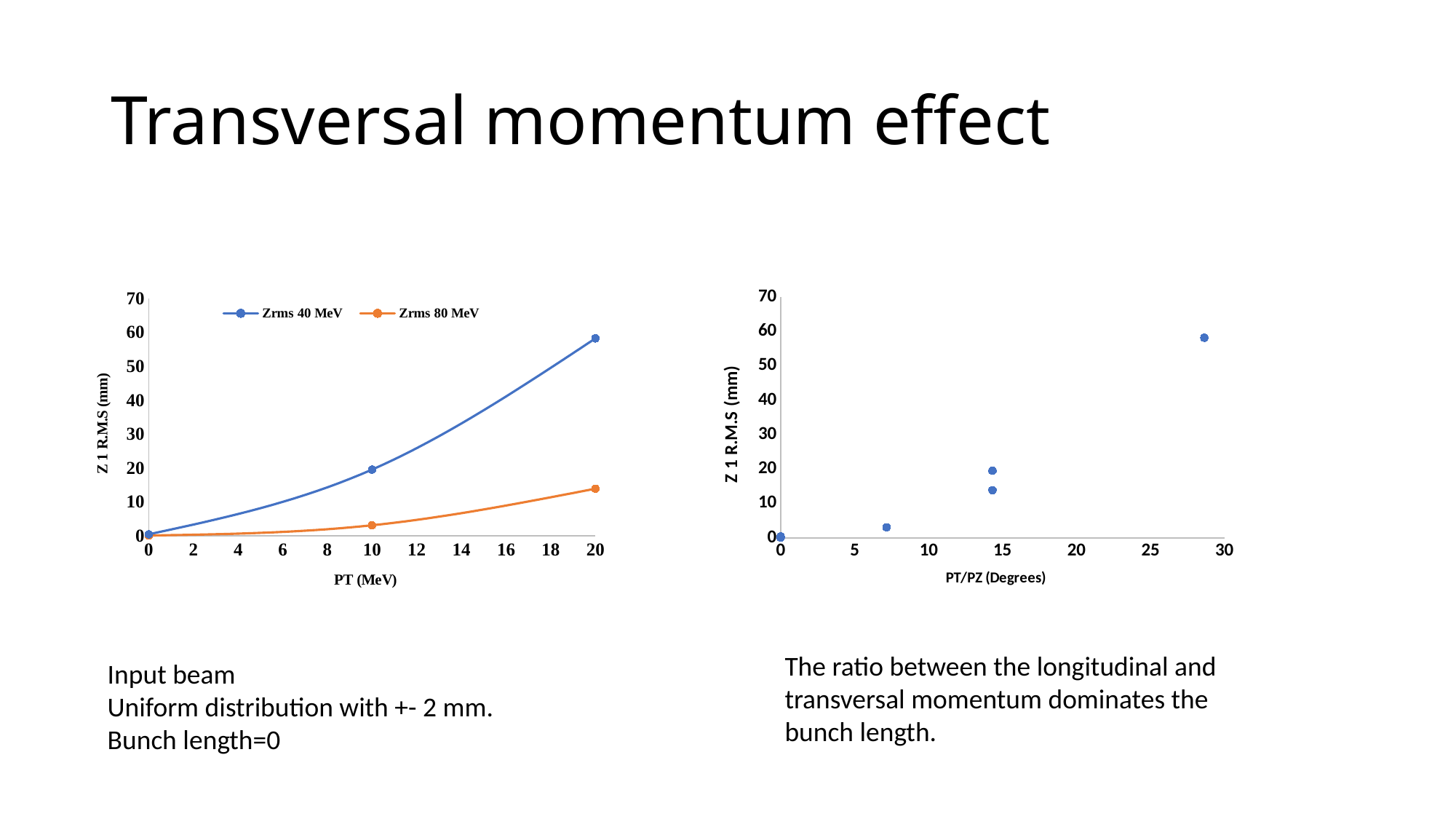
On the left chart, at PT = 10 MeV, which series has the larger value, Zrms 40 MeV or Zrms 80 MeV? Zrms 40 MeV What kind of chart is the left chart? line chart On the right chart, is the value of the point at the highest PT/PZ greater or less than 50? greater On the left chart, how many data points are plotted for the Zrms 40 MeV series? 3 On the left chart, how many series does the legend list? 2 On the left chart, what are the names of the series in the legend? Zrms 40 MeV and Zrms 80 MeV What is the x-axis title of the right chart? PT/PZ (Degrees) On the left chart, is the value of Zrms 80 MeV at PT = 20 MeV greater or less than 20? less What kind of chart is the right chart? scatter chart On the left chart, do the values of Zrms 40 MeV rise or fall as PT increases? rise On the left chart, is the value of Zrms 40 MeV at PT = 20 MeV greater or less than 50? greater